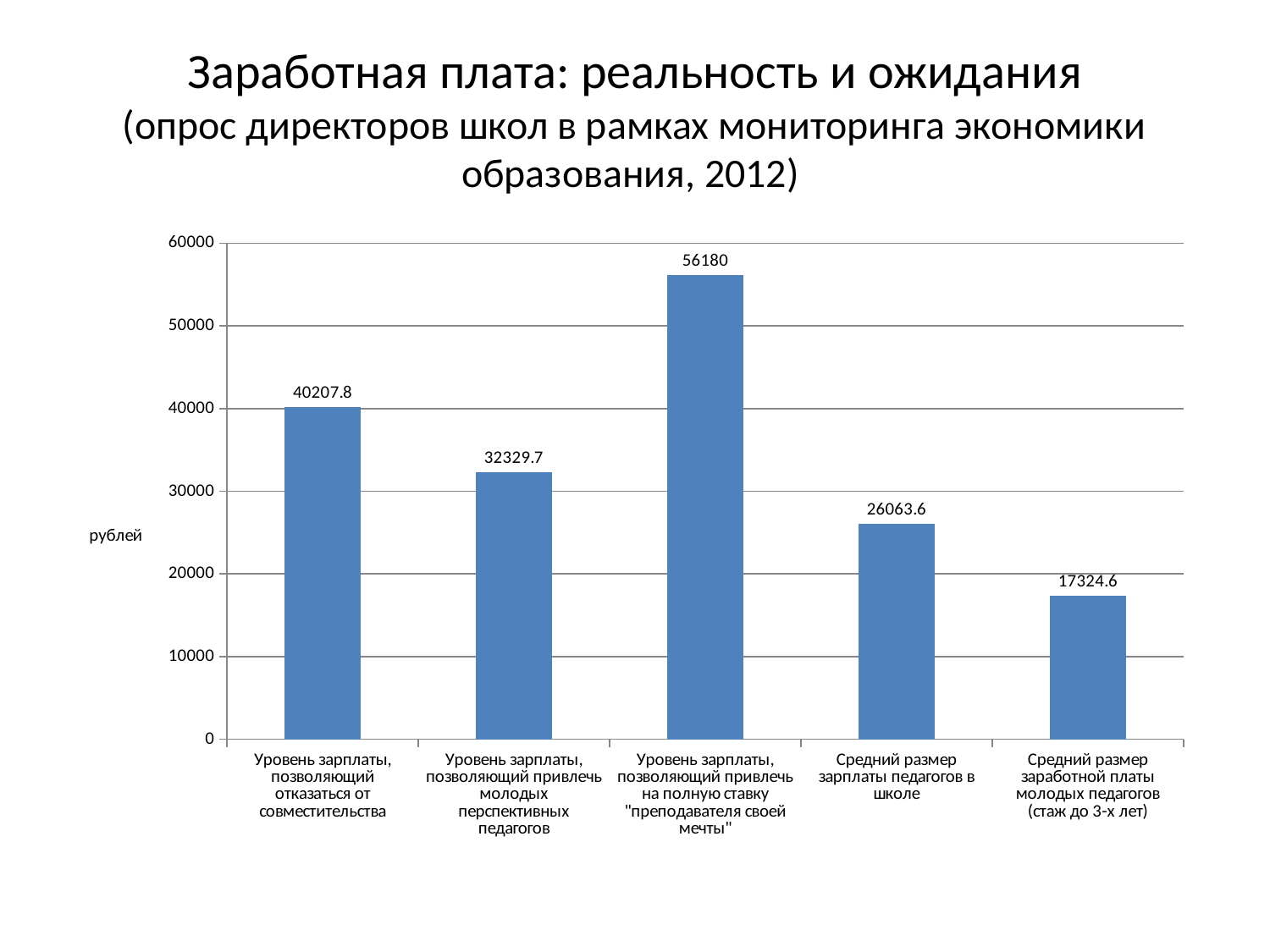
Which category has the highest value? Уровень зарплаты, позволяющий привлечь на полную ставку "преподавателя своей мечты" Is the value for "Уровень зарплаты, позволяющий привлечь молодых перспективных педагогов" greater or less than 30000? greater What value is shown for "Уровень зарплаты, позволяющий отказаться от совместительства"? 40207.8 How many categories are shown in the chart? 5 What kind of chart is shown on the slide? bar chart What is the difference between the value for "Уровень зарплаты, позволяющий отказаться от совместительства" and the value for "Уровень зарплаты, позволяющий привлечь молодых перспективных педагогов"? 7878.1 What value is shown for "Средний размер заработной платы молодых педагогов (стаж до 3-х лет)"? 17324.6 What value is shown for "Средний размер зарплаты педагогов в школе"? 26063.6 Which is larger: the value for "Уровень зарплаты, позволяющий привлечь молодых перспективных педагогов" or the value for "Средний размер зарплаты педагогов в школе"? Уровень зарплаты, позволяющий привлечь молодых перспективных педагогов Which category has the lowest value? Средний размер заработной платы молодых педагогов (стаж до 3-х лет) What value is shown for "Уровень зарплаты, позволяющий привлечь на полную ставку "преподавателя своей мечты""? 56180 What is the difference between the value for "Средний размер зарплаты педагогов в школе" and the value for "Средний размер заработной платы молодых педагогов (стаж до 3-х лет)"? 8739